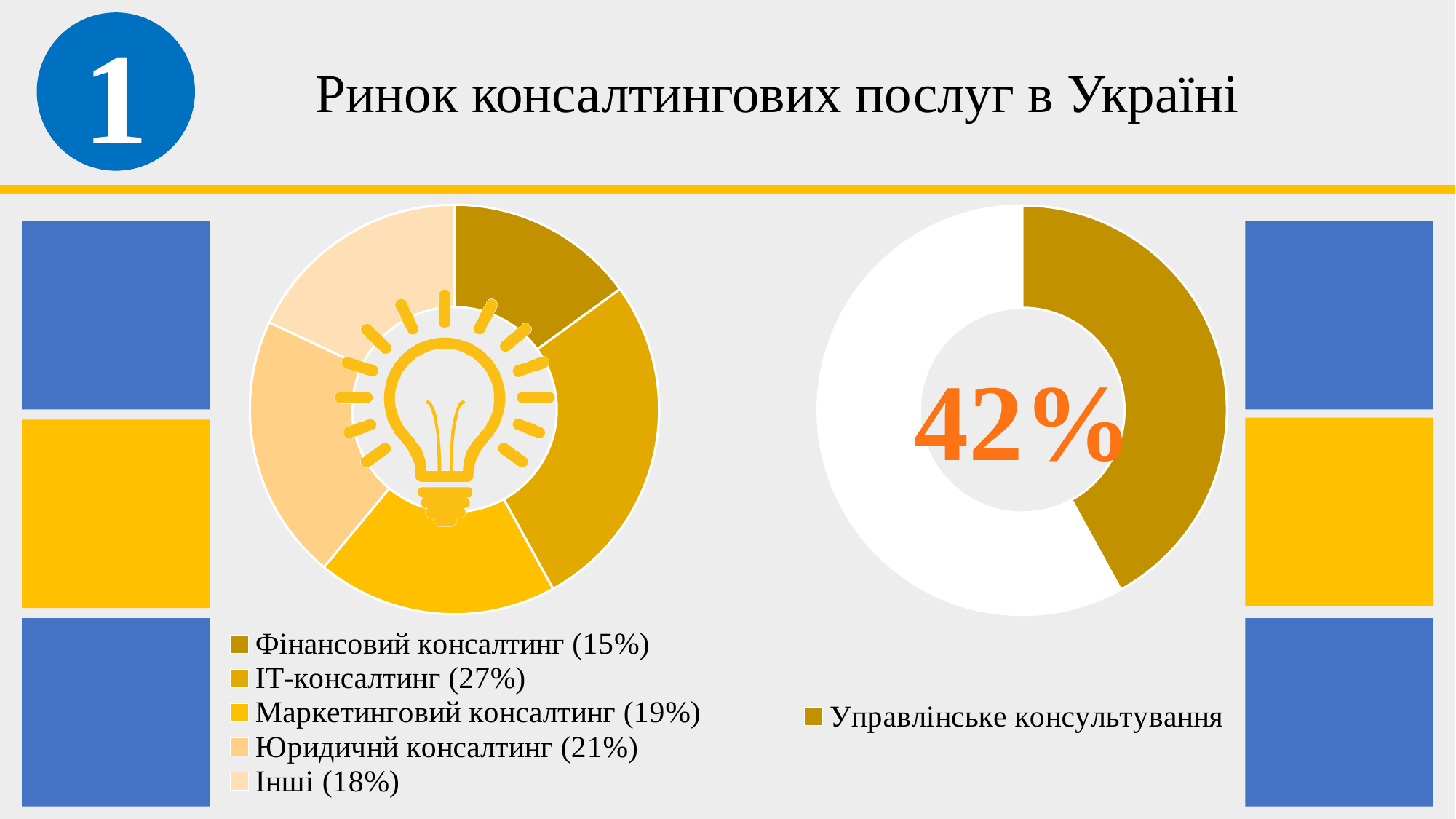
In the left chart, what share does Юридичний консалтинг have? 21% What is the title of the slide containing the charts? Ринок консалтингових послуг в Україні In the left chart, which category has the smallest share? Фінансовий консалтинг In the left chart, what is the difference in percentage points between IT-консалтинг and Фінансовий консалтинг? 12 In the right chart, what value is shown for Управлінське консультування? 42% In the left chart, which is larger: Юридичний консалтинг or Маркетинговий консалтинг? Юридичний консалтинг In the left chart, what share does IT-консалтинг have? 27% In the left chart, which category has the largest share? IT-консалтинг What kind of chart is the left chart? Pie (doughnut) chart In the left chart, what share does Інші have? 18% How many categories does the left chart show? 5 What is the legend entry of the right chart? Управлінське консультування